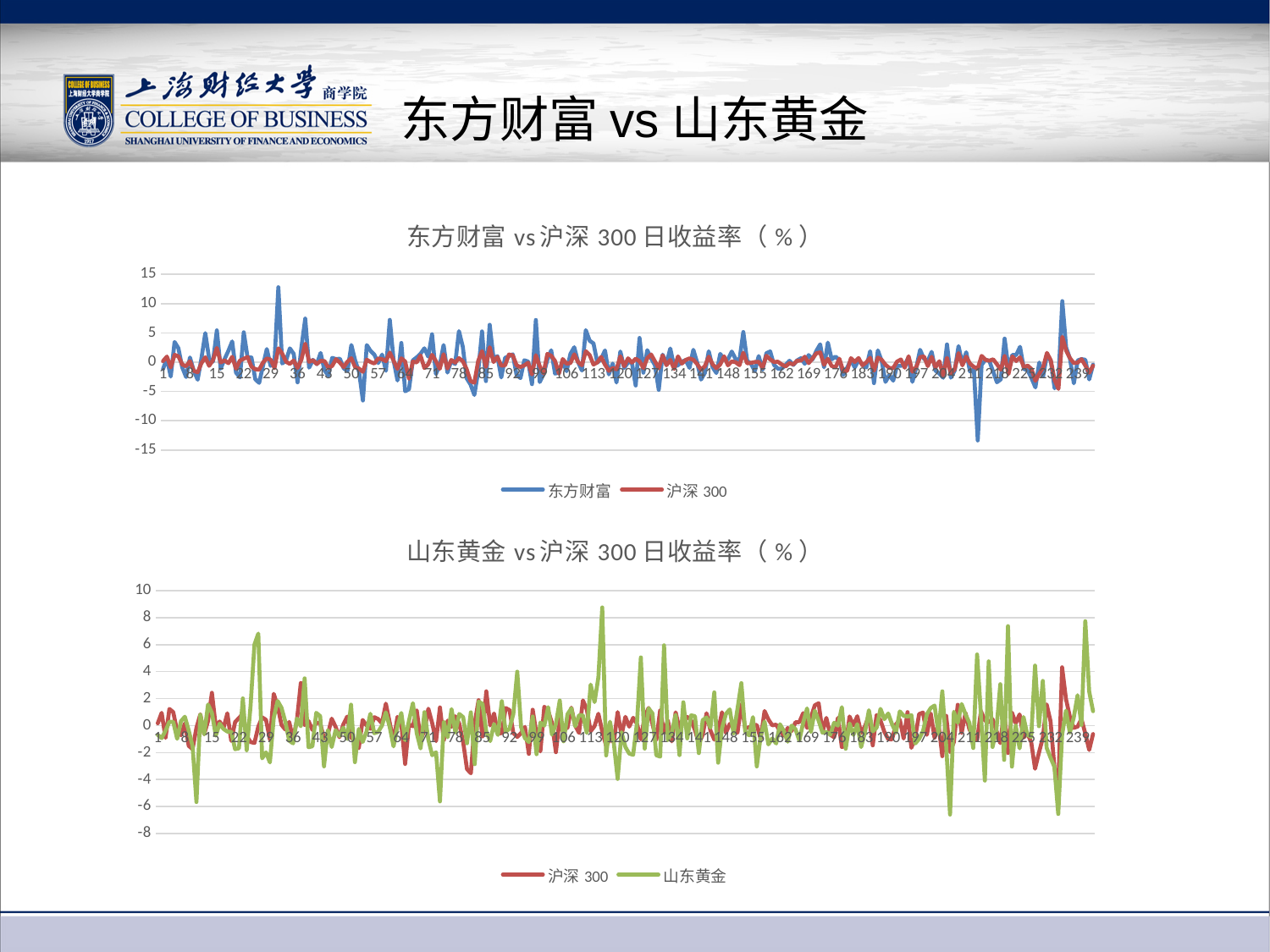
What kind of chart is the bottom chart titled 山东黄金 vs沪深 300 日收益率（%）? line chart In the top chart (东方财富 vs沪深 300 日收益率), is the lowest value reached by the 东方财富 series greater or less than -10? less In the top chart (东方财富 vs沪深 300 日收益率), is the highest value reached by the 东方财富 series greater or less than 10? greater In the bottom chart (山东黄金 vs沪深 300 日收益率), how many series does the legend list? 2 In the top chart (东方财富 vs沪深 300 日收益率), which series is drawn in blue? 东方财富 What kind of chart is the top chart titled 东方财富 vs沪深 300 日收益率（%）? line chart In the bottom chart (山东黄金 vs沪深 300 日收益率), is the lowest value reached by the 山东黄金 series greater or less than -6? less In the top chart (东方财富 vs沪深 300 日收益率), how many series does the legend list? 2 In the bottom chart (山东黄金 vs沪深 300 日收益率), which series is drawn in green? 山东黄金